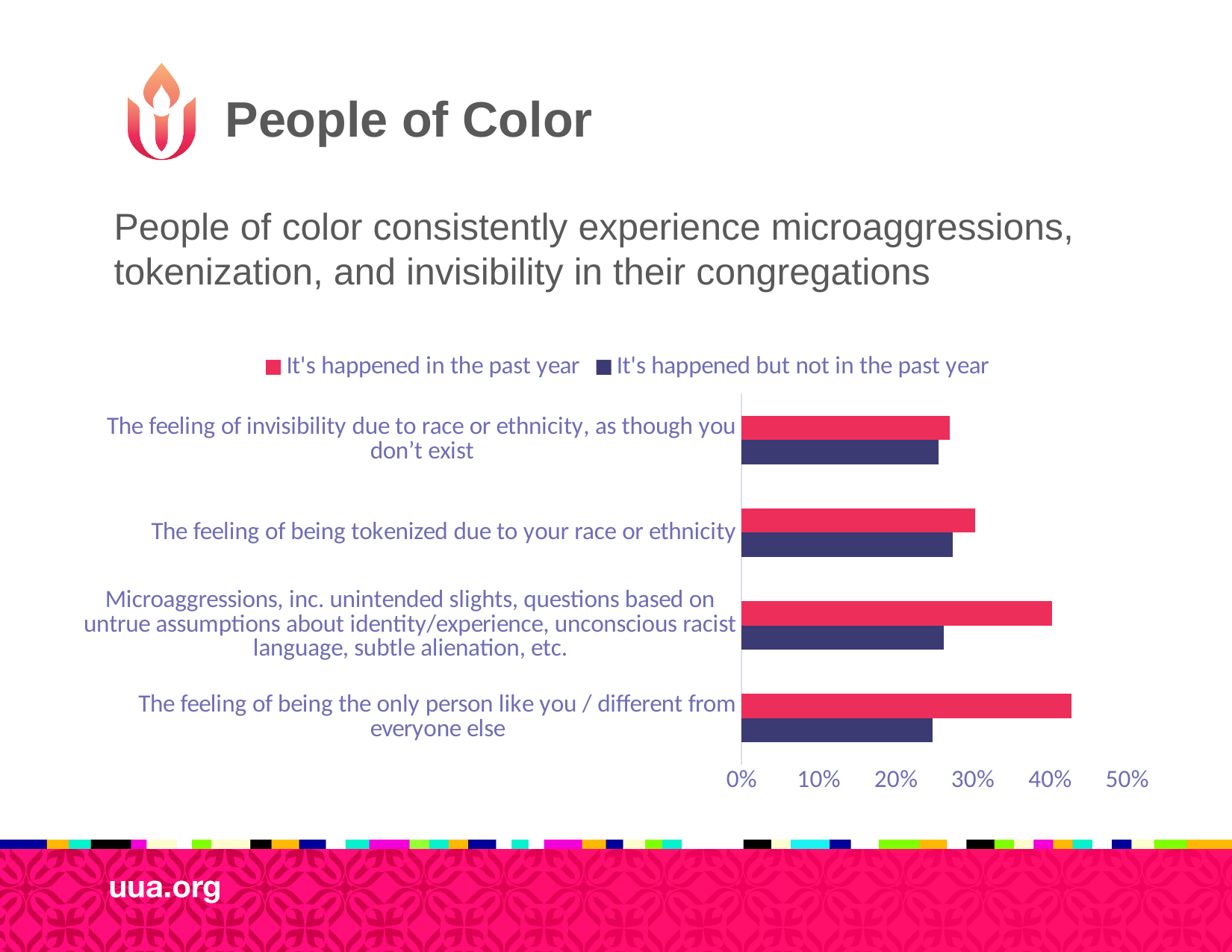
For the feeling of being the only person like you, which series has the larger value: "It's happened in the past year" or "It's happened but not in the past year"? It's happened in the past year Is the "It's happened in the past year" value for Microaggressions greater or less than 30%? greater How many categories are plotted on the chart? 4 How many series does the legend list? 2 Is the "It's happened in the past year" value for the feeling of invisibility greater or less than 30%? less Which category has the lowest value for "It's happened in the past year"? The feeling of invisibility due to race or ethnicity, as though you don't exist Is the "It's happened in the past year" value for the feeling of being the only person like you greater or less than 40%? greater Which category has the highest value for "It's happened in the past year"? The feeling of being the only person like you / different from everyone else Which colour represents the series "It's happened but not in the past year"? dark blue For Microaggressions, which series has the larger value: "It's happened in the past year" or "It's happened but not in the past year"? It's happened in the past year What kind of chart is shown on the slide? bar chart